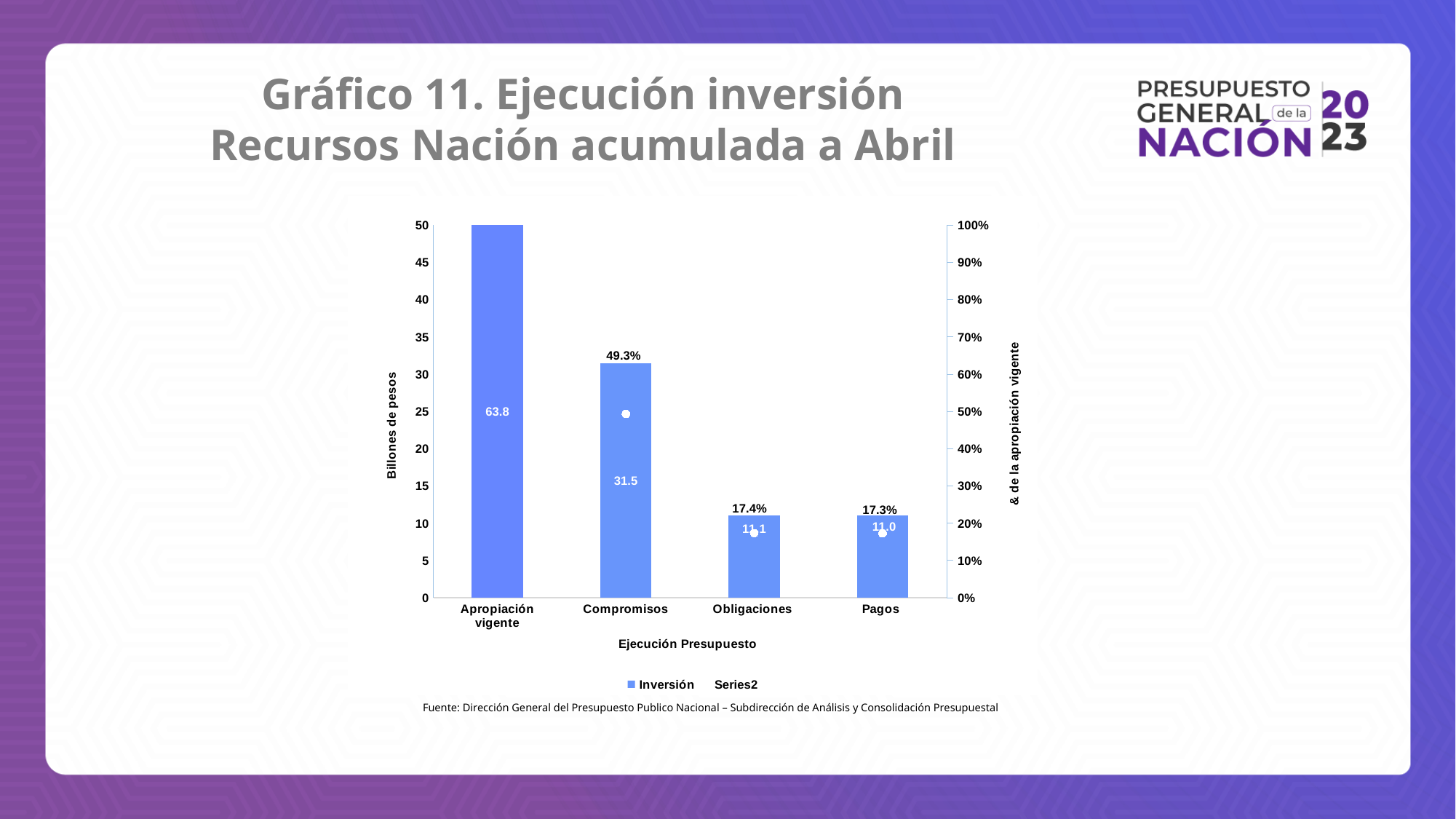
How many series does the legend list? 2 How many categories are shown on the x axis? 4 What is the value labelled on the Apropiación vigente bar? 63.8 What percentage is shown above the Pagos bar? 17.3% What percentage of the apropiación vigente is shown for Compromisos? 49.3% What is the difference between the Apropiación vigente value and the Compromisos value in billones de pesos? 32.3 Which category has the highest value in billones de pesos? Apropiación vigente Which is larger, the value for Compromisos or the value for Obligaciones? Compromisos What is the value for Compromisos in billones de pesos? 31.5 What percentage is shown above the Obligaciones bar? 17.4% What kind of chart is shown on the slide? Bar chart Do the bar values rise or fall from Apropiación vigente to Pagos? Fall